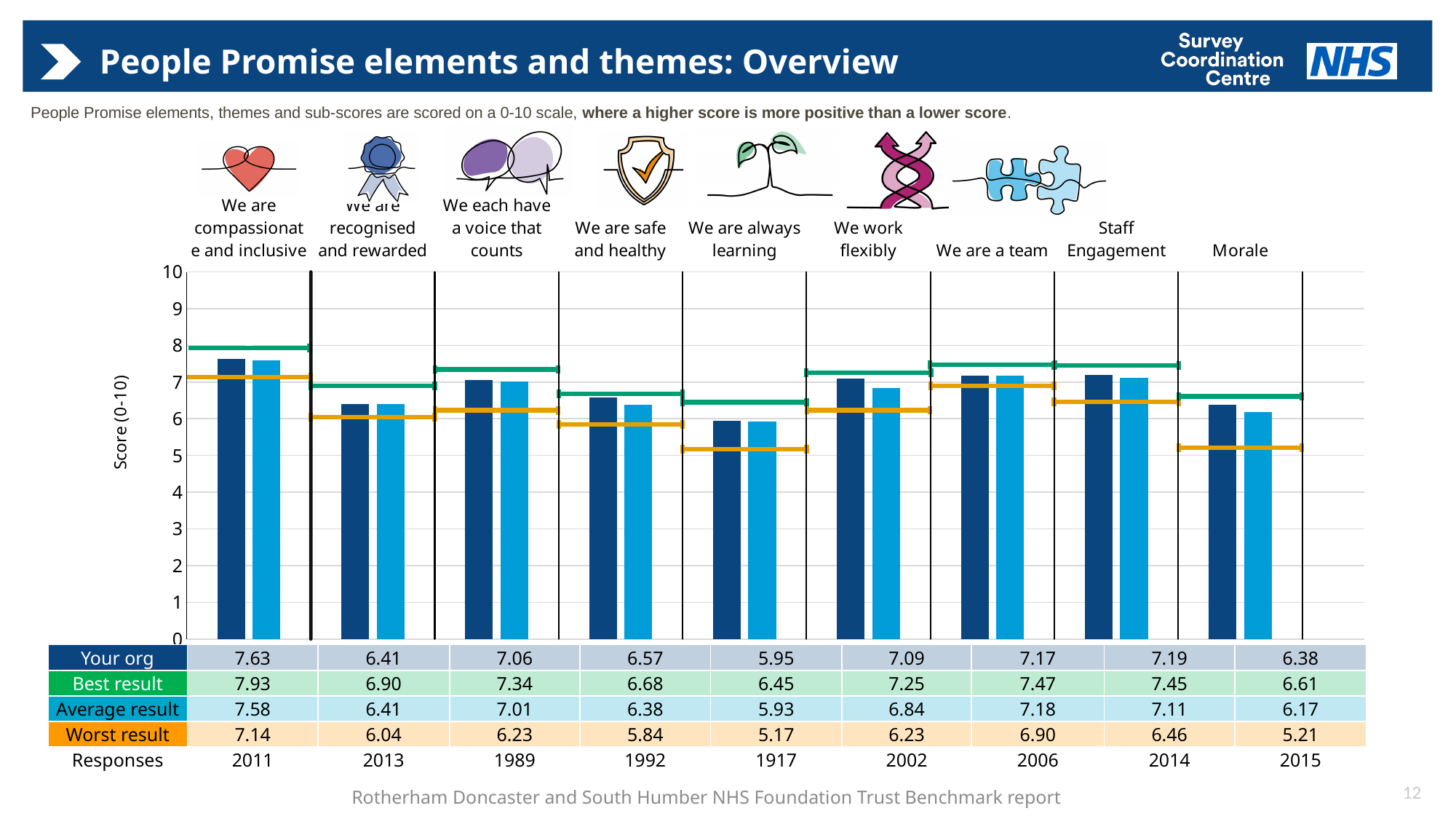
What is the Best result score for Staff Engagement? 7.45 What is the difference between the Best result and the Worst result for Morale? 1.40 What kind of chart is shown on the slide? Bar chart Which element has the lowest Your org score? We are always learning What is the Worst result score for Morale? 5.21 For Staff Engagement, which is larger: the Your org score or the Average result? Your org Which element has the highest Your org score? We are compassionate and inclusive What is the difference between the Your org score and the Average result for We work flexibly? 0.25 Is the Your org score for We are compassionate and inclusive greater or less than 7? greater What is the Your org score for We are always learning? 5.95 How many elements or themes are plotted on the chart? 9 How many responses are recorded for We are safe and healthy? 1992